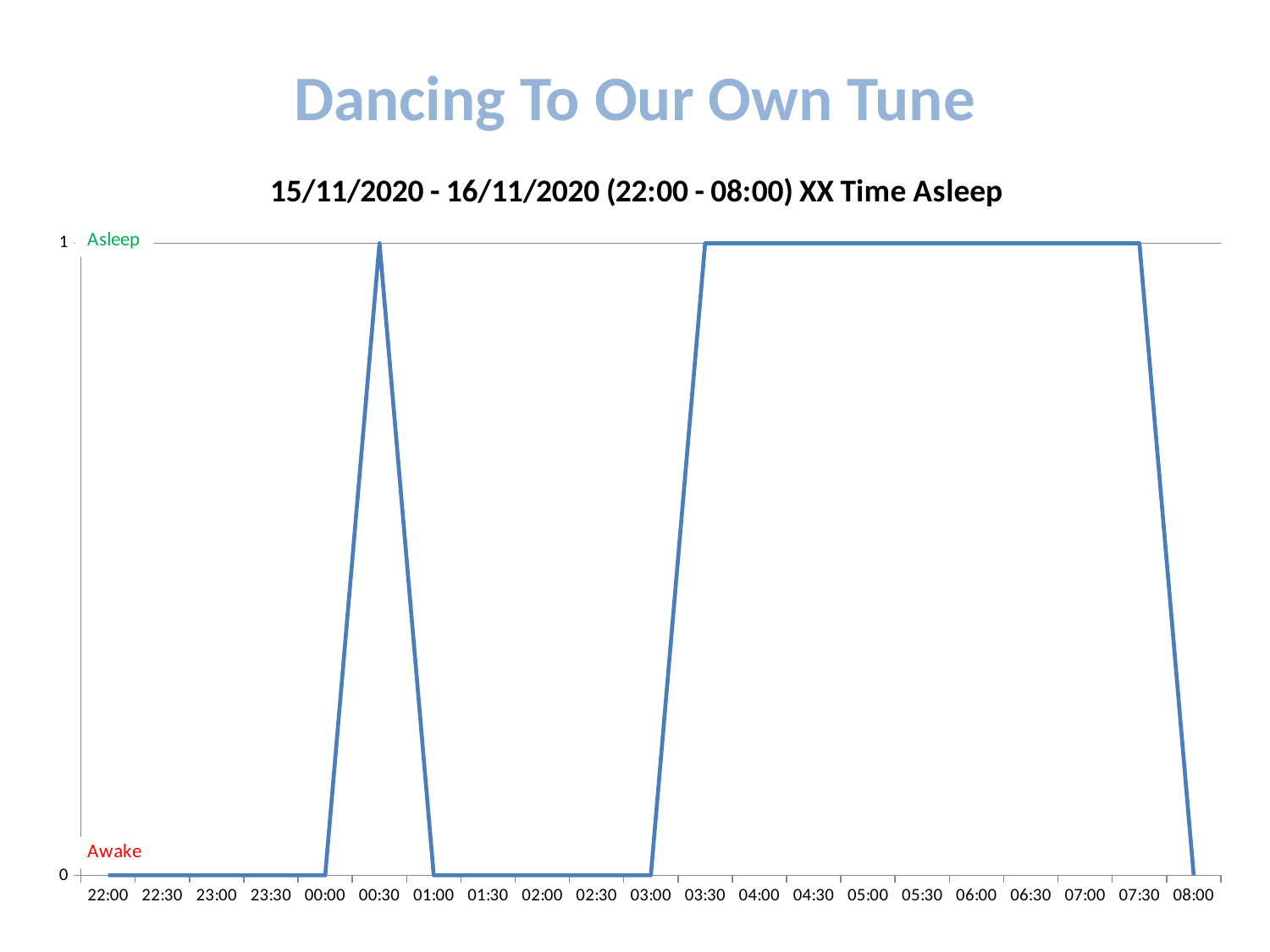
What is the value at 22:00? 0 What is the difference between the value at 06:00 and the value at 02:30? 1 Does the line rise or fall between 07:30 and 08:00? fall What label is shown next to the value 1 on the y axis? Asleep How many time points are shown on the x axis? 21 What is the value at 02:00? 0 What type of chart is shown on the slide? line chart What is the value at 05:00? 1 What is the chart's title? 15/11/2020 - 16/11/2020 (22:00 - 08:00) XX Time Asleep Which is larger, the value at 04:00 or the value at 01:30? 04:00 What is the value at 08:00? 0 What is the value at 00:30? 1